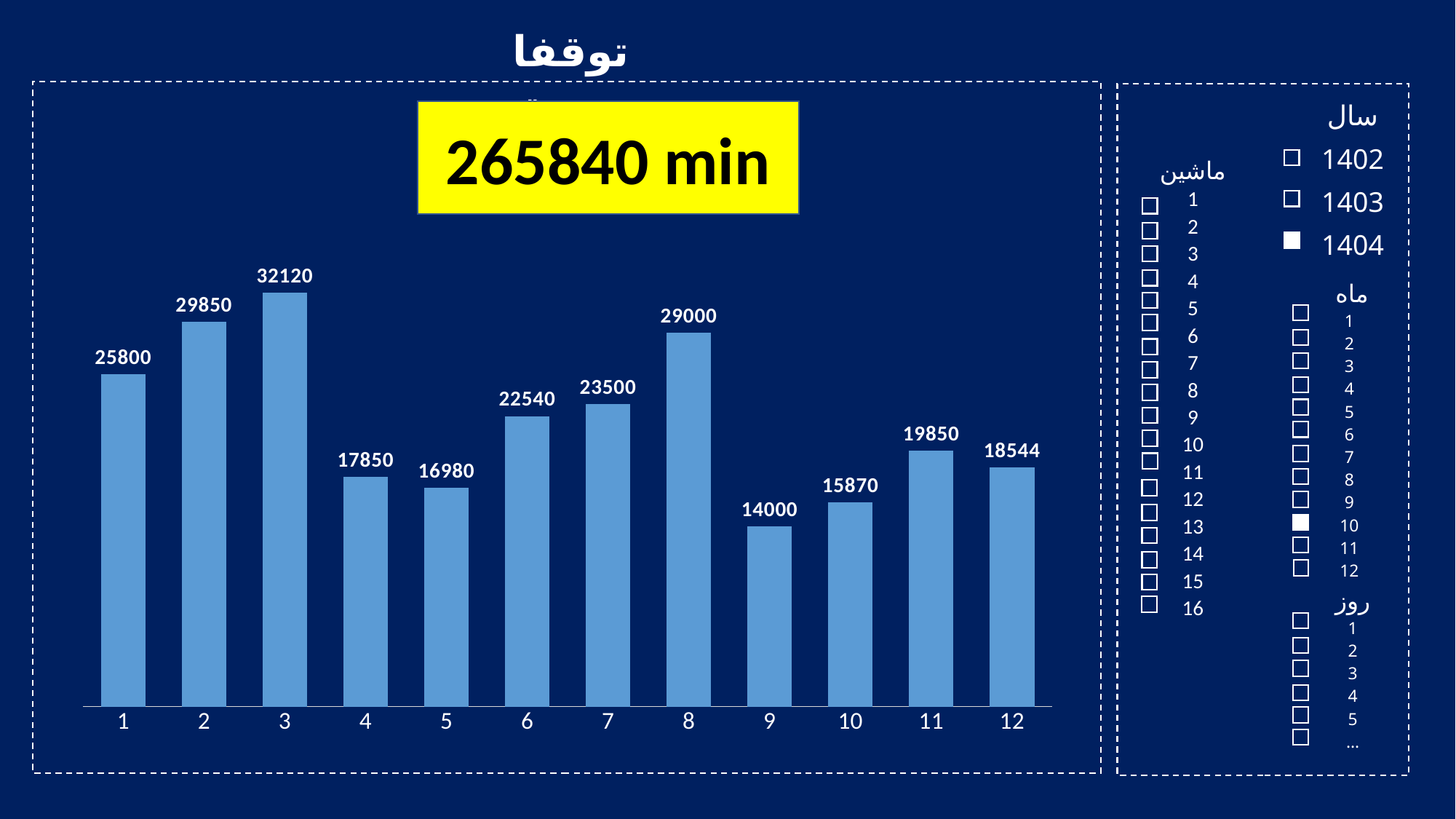
What value is printed in the yellow box above the chart? 265840 min Which category has the highest value? 3 Do the values rise or fall from category 1 to category 3? rise What is the difference between the values for category 2 and category 1? 4050 What is the difference between the values for category 3 and category 9? 18120 What is the value for category 12? 18544 What is the value for category 1? 25800 What kind of chart is shown on the slide? bar chart Which category has the lowest value? 9 What is the value for category 8? 29000 Which is larger, the value for category 6 or the value for category 7? 7 How many categories are shown on the x axis? 12